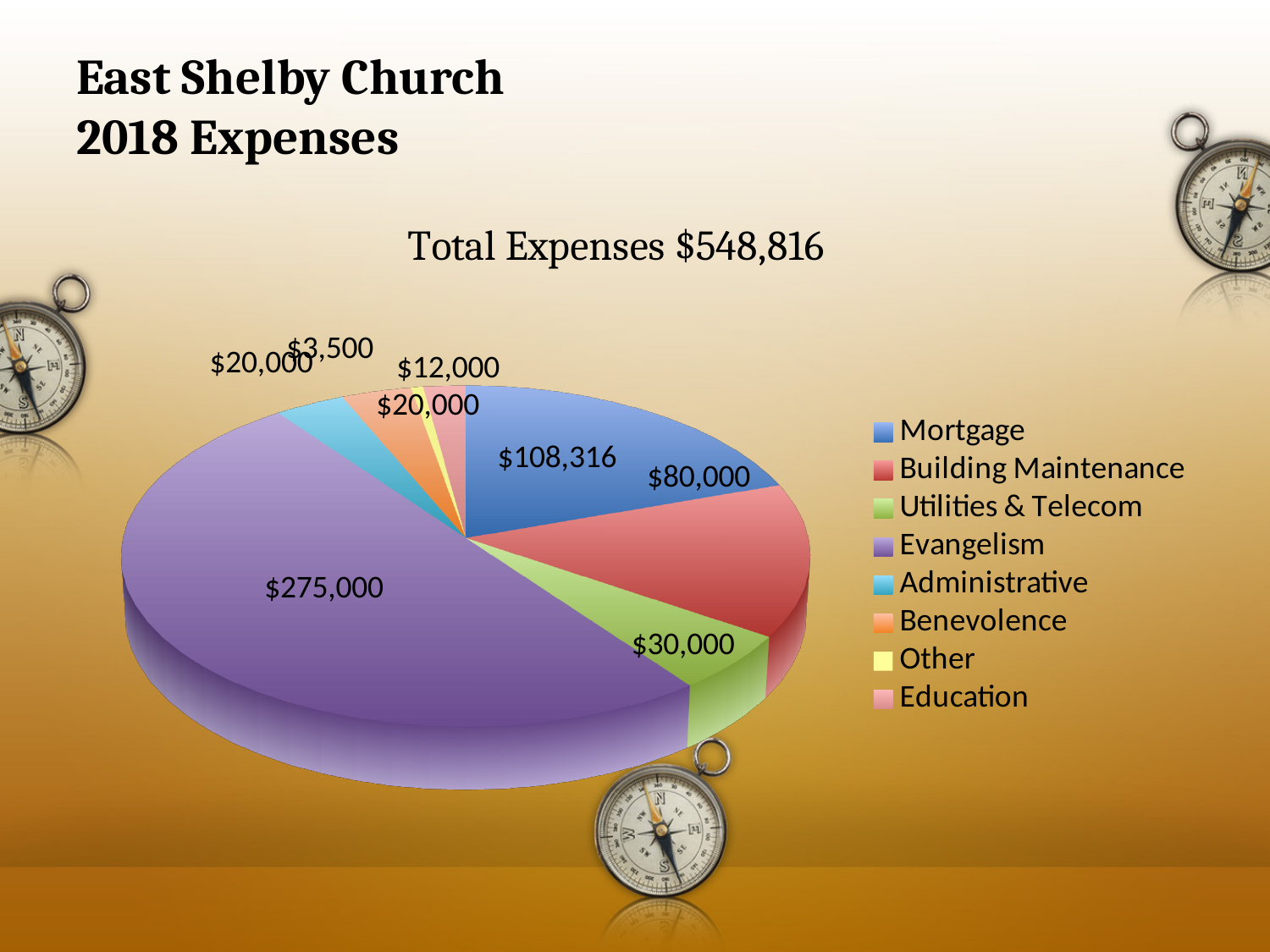
What is the value of the Utilities & Telecom slice? $30,000 Which expense category has the largest slice? Evangelism Which expense category has the smallest slice? Other What is the value of the Education slice? $12,000 What kind of chart is shown on the slide? Pie chart How many expense categories does the pie chart show? 8 What is the value of the Building Maintenance slice? $80,000 What is the title of the pie chart? Total Expenses $548,816 How much larger is the Evangelism expense than the Mortgage expense? $166,684 Which is larger, Building Maintenance or Utilities & Telecom? Building Maintenance What is the value of the Evangelism slice? $275,000 What is the value of the Mortgage slice? $108,316